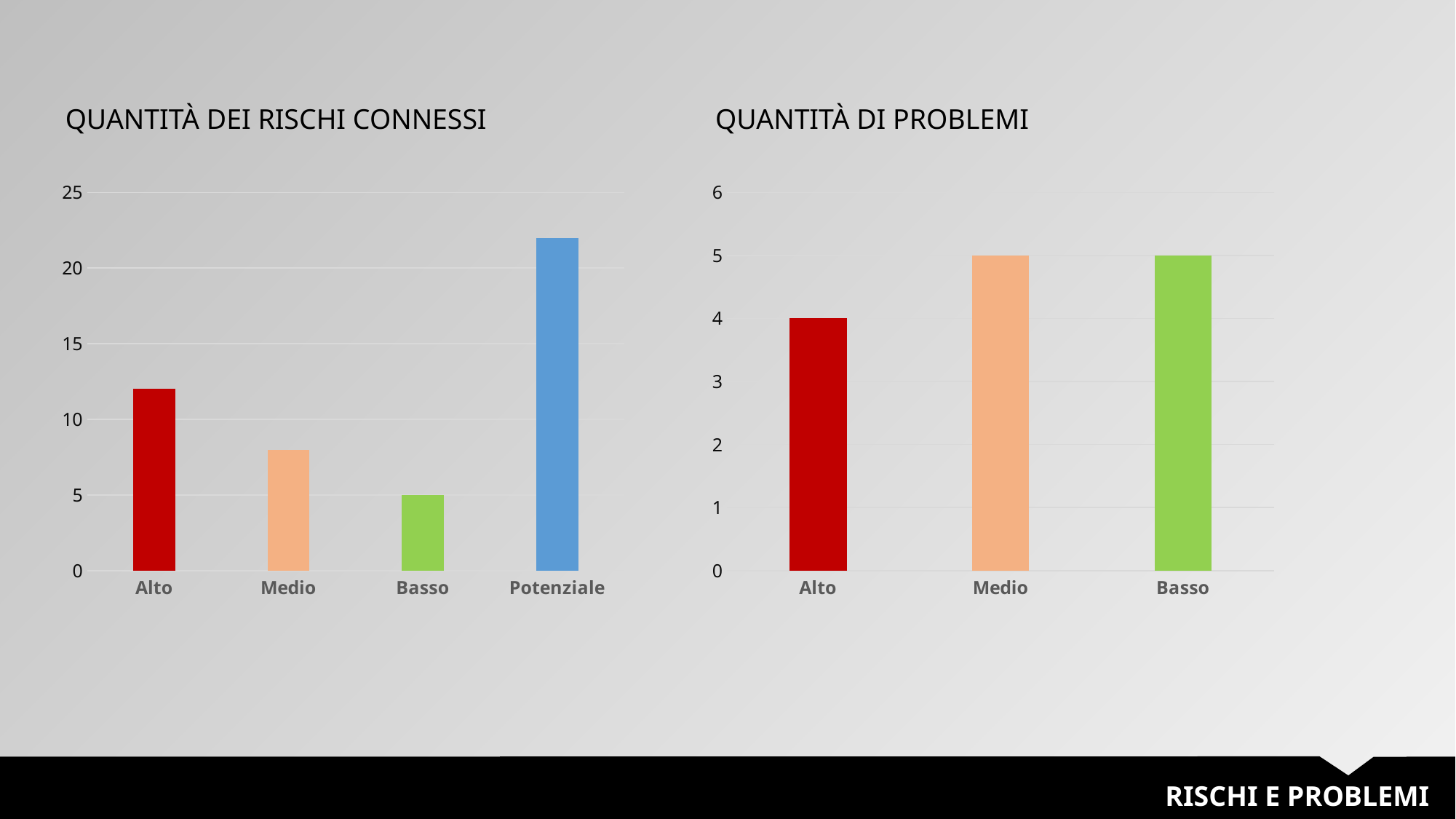
In the chart titled QUANTITÀ DEI RISCHI CONNESSI, which is larger, the value for Alto or the value for Medio? Alto In the chart titled QUANTITÀ DI PROBLEMI, what is the difference between the values for Medio and Alto? 1 What kind of chart is the chart titled QUANTITÀ DI PROBLEMI? bar chart In the chart titled QUANTITÀ DEI RISCHI CONNESSI, is the value for Alto greater or less than 10? greater In the chart titled QUANTITÀ DEI RISCHI CONNESSI, what is the value for Basso? 5 In the chart titled QUANTITÀ DI PROBLEMI, which category has the lowest value? Alto In the chart titled QUANTITÀ DI PROBLEMI, what is the value for Alto? 4 In the chart titled QUANTITÀ DI PROBLEMI, what is the value for Medio? 5 How many categories are shown in the chart titled QUANTITÀ DEI RISCHI CONNESSI? 4 In the chart titled QUANTITÀ DEI RISCHI CONNESSI, is the value for Potenziale greater or less than 20? greater In the chart titled QUANTITÀ DEI RISCHI CONNESSI, which category has the lowest value? Basso In the chart titled QUANTITÀ DEI RISCHI CONNESSI, which category has the highest value? Potenziale